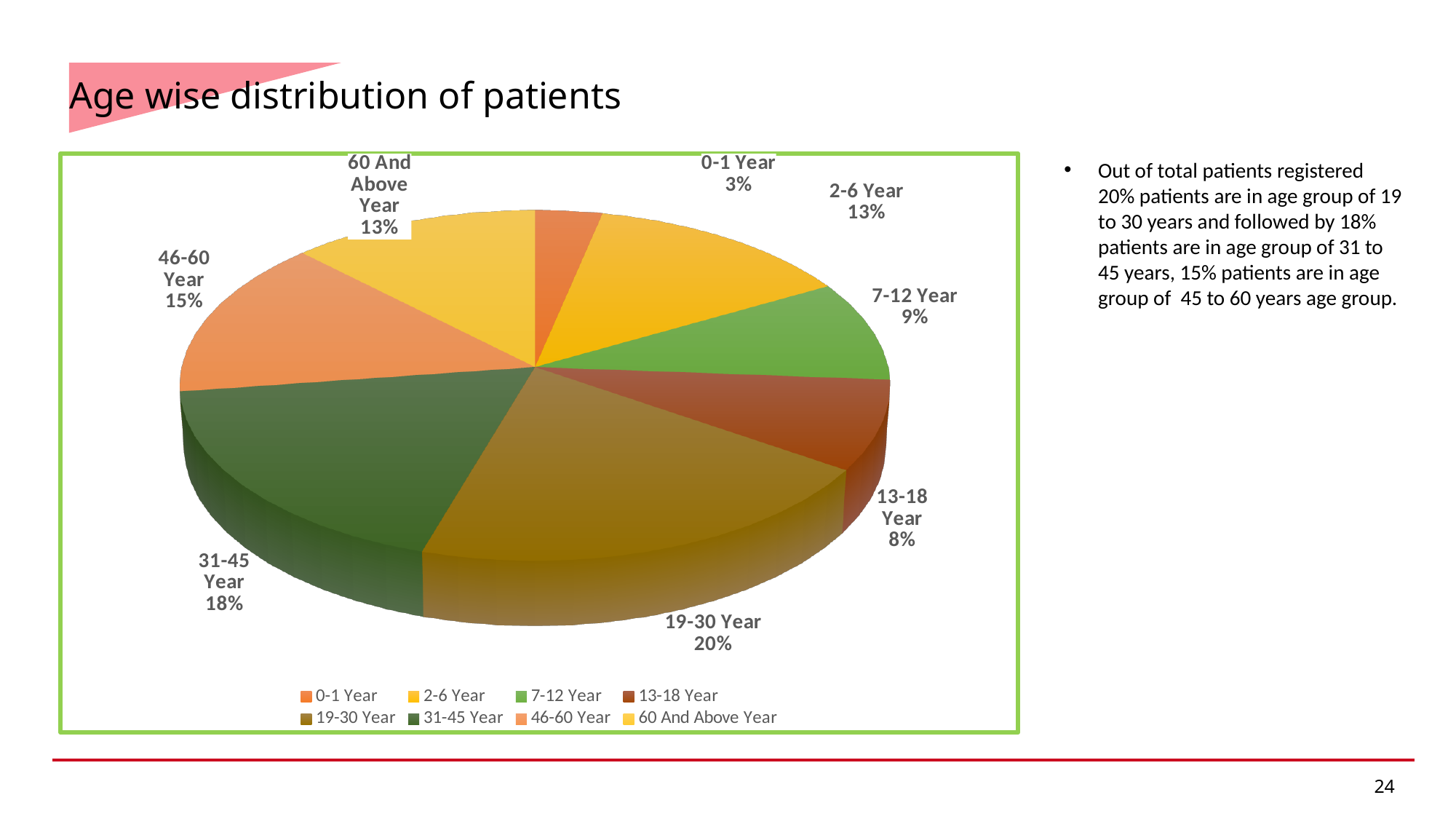
How many entries does the legend list? 8 What is the title of the slide containing the chart? Age wise distribution of patients How many age groups are shown in the pie chart? 8 What share of patients are in the 19-30 Year age group? 20% Which age group has a larger share, 2-6 Year or 7-12 Year? 2-6 Year What is the difference in percentage points between the 31-45 Year and 13-18 Year age groups? 10 Which age group has the largest share of patients? 19-30 Year What share of patients are in the 46-60 Year age group? 15% What share of patients are in the 7-12 Year age group? 9% Which age group has the smallest share of patients? 0-1 Year What kind of chart is shown on the slide? Pie chart